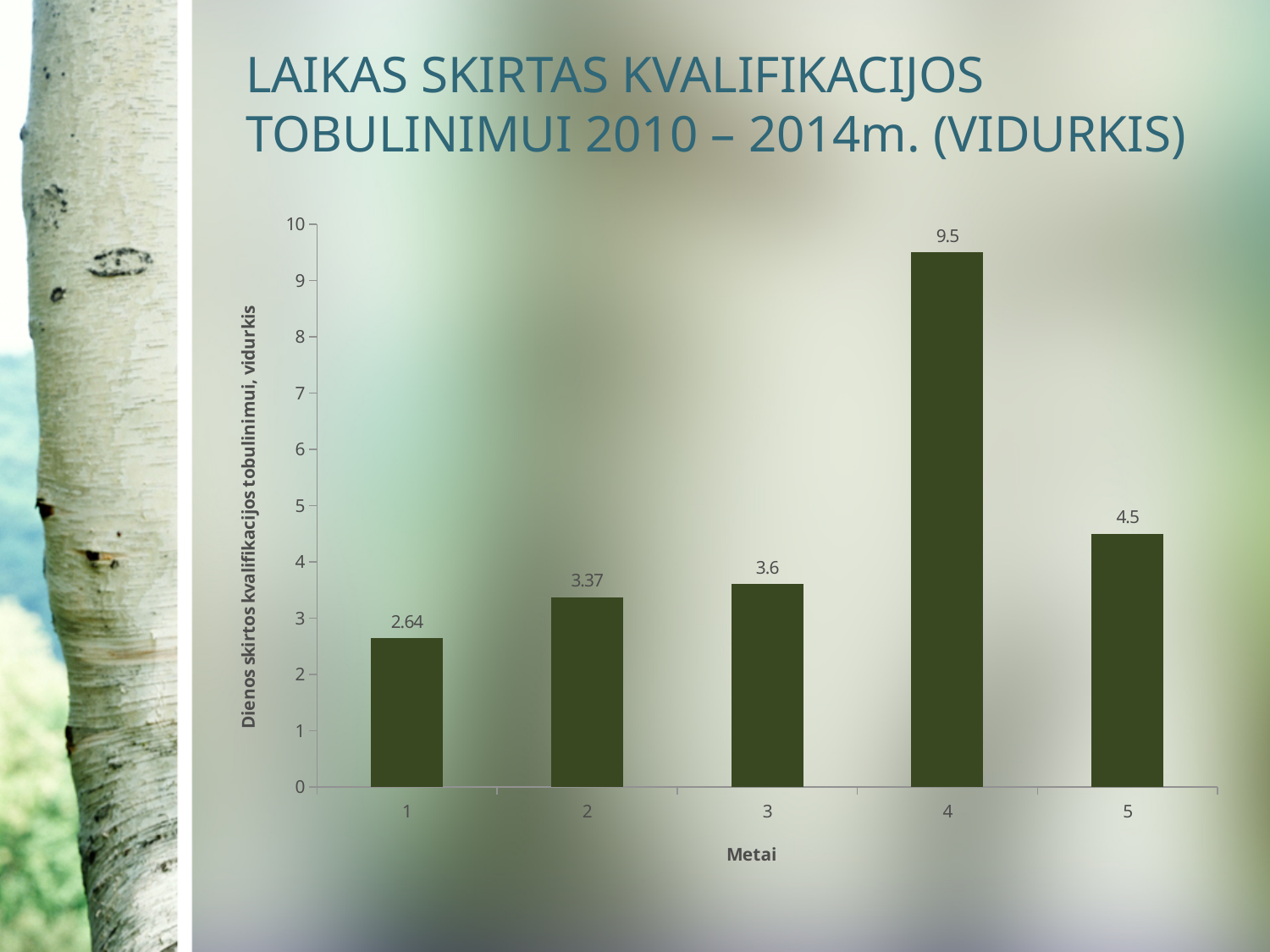
What is the value for category 1? 2.64 What is the label of the x axis? Metai How many categories are shown on the x axis? 5 What is the value for category 5? 4.5 What kind of chart is shown on the slide? bar chart Which category has the lowest value? 1 What is the value for category 4? 9.5 Is the value for category 4 greater or less than 9? greater Which category has the highest value? 4 Which is larger, the value for category 2 or the value for category 3? 3 What is the difference between the values for category 4 and category 5? 5 What is the difference between the values for category 3 and category 2? 0.23